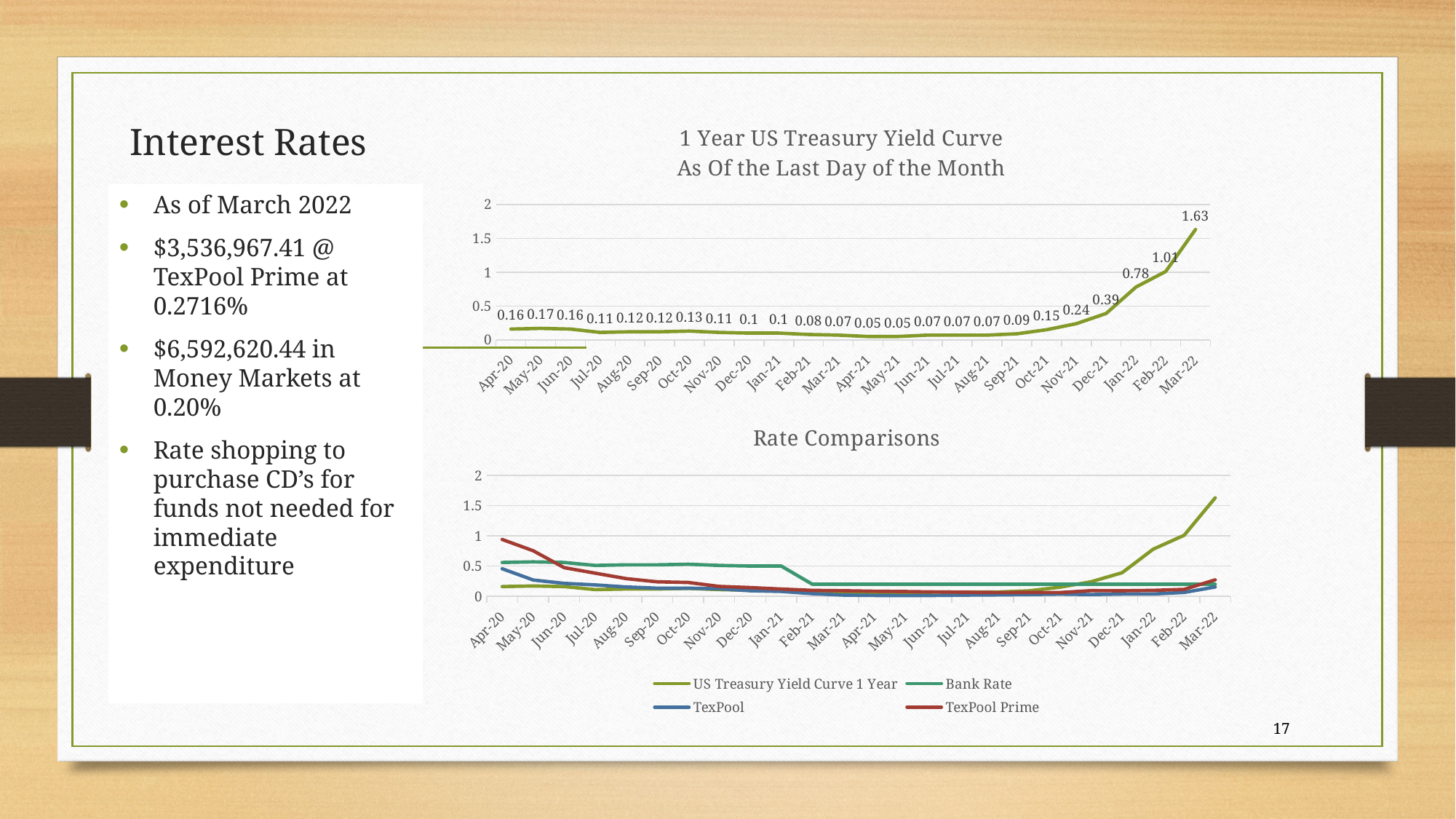
In the 'Rate Comparisons' chart, which series is shown in red? TexPool Prime How many months are plotted in the '1 Year US Treasury Yield Curve' chart? 24 How many series does the legend of the 'Rate Comparisons' chart list? 4 In the '1 Year US Treasury Yield Curve' chart, what is the difference between the Mar-22 and Feb-22 values? 0.62 In the '1 Year US Treasury Yield Curve' chart, what is the value for Apr-20? 0.16 In the '1 Year US Treasury Yield Curve' chart, what is the value for Dec-21? 0.39 In the 'Rate Comparisons' chart, is the TexPool Prime value for Apr-20 greater or less than 0.5? greater In the '1 Year US Treasury Yield Curve' chart, how do the values change from Sep-21 to Mar-22? They rise In the '1 Year US Treasury Yield Curve' chart, which is larger, the value for Jan-22 or the value for Nov-21? Jan-22 In the '1 Year US Treasury Yield Curve' chart, what is the value for Mar-22? 1.63 What type of chart is the 'Rate Comparisons' chart? Line chart In the '1 Year US Treasury Yield Curve' chart, which month has the highest value? Mar-22